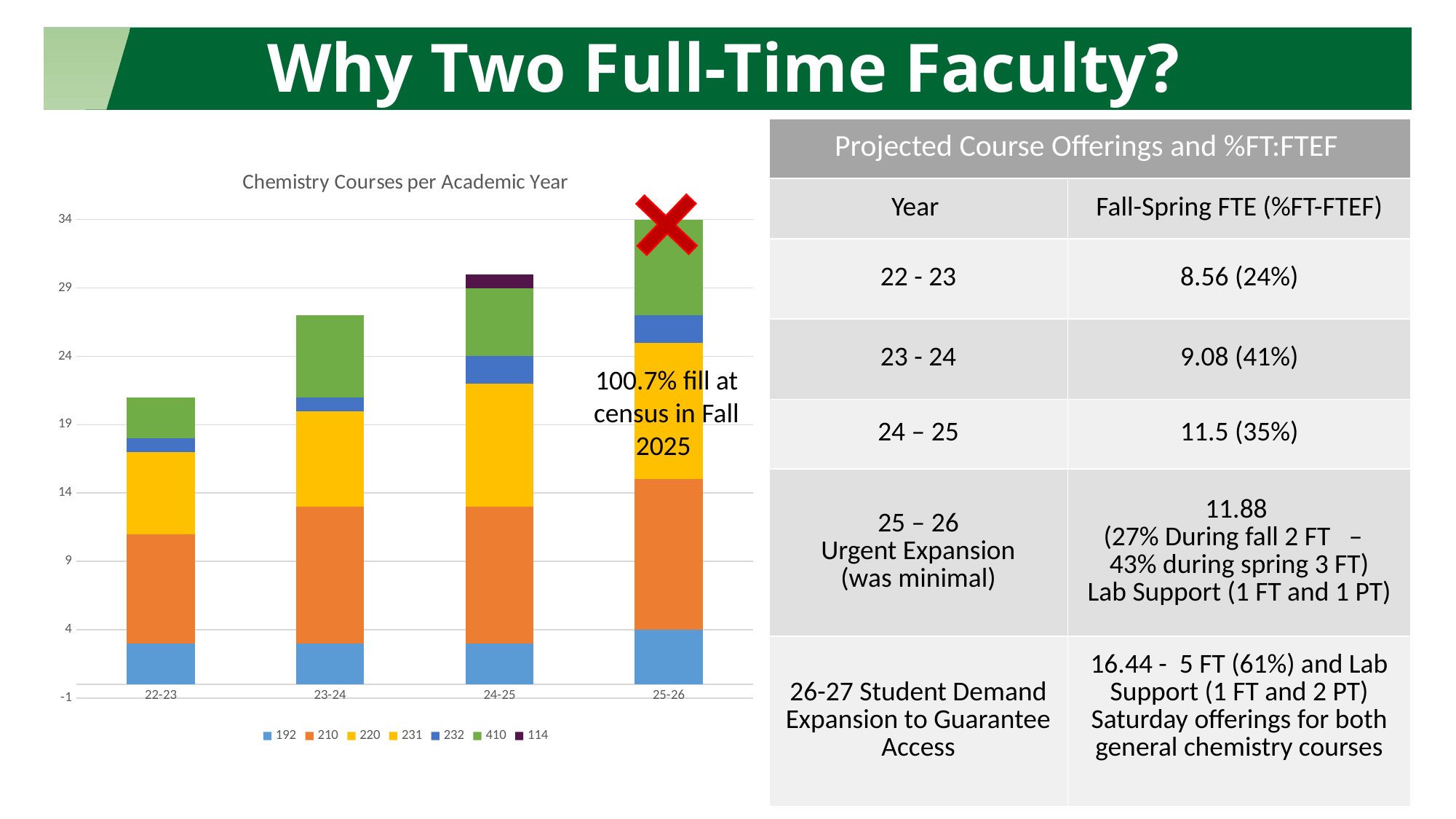
In the Chemistry Courses per Academic Year chart, which stacked bar is taller, 23-24 or 24-25? 24-25 What kind of chart is the Chemistry Courses per Academic Year chart? Stacked bar chart In the Chemistry Courses per Academic Year chart, is the total stacked bar for 23-24 greater or less than 24? greater Which academic year has the tallest stacked bar in the Chemistry Courses per Academic Year chart? 25-26 Do the total stacked bar heights in the Chemistry Courses per Academic Year chart rise or fall from 22-23 to 25-26? Rise In the Chemistry Courses per Academic Year chart, is the total stacked bar for 24-25 greater or less than 29? greater Which academic year has the shortest stacked bar in the Chemistry Courses per Academic Year chart? 22-23 How many series does the legend of the Chemistry Courses per Academic Year chart list? 7 How many academic years are shown on the x axis of the Chemistry Courses per Academic Year chart? 4 In the Chemistry Courses per Academic Year chart, is the total stacked bar for 22-23 greater or less than 24? less What is the title of the chart on the left of the slide? Chemistry Courses per Academic Year In the Chemistry Courses per Academic Year chart, which academic year is the only one with a segment for the 114 series? 24-25